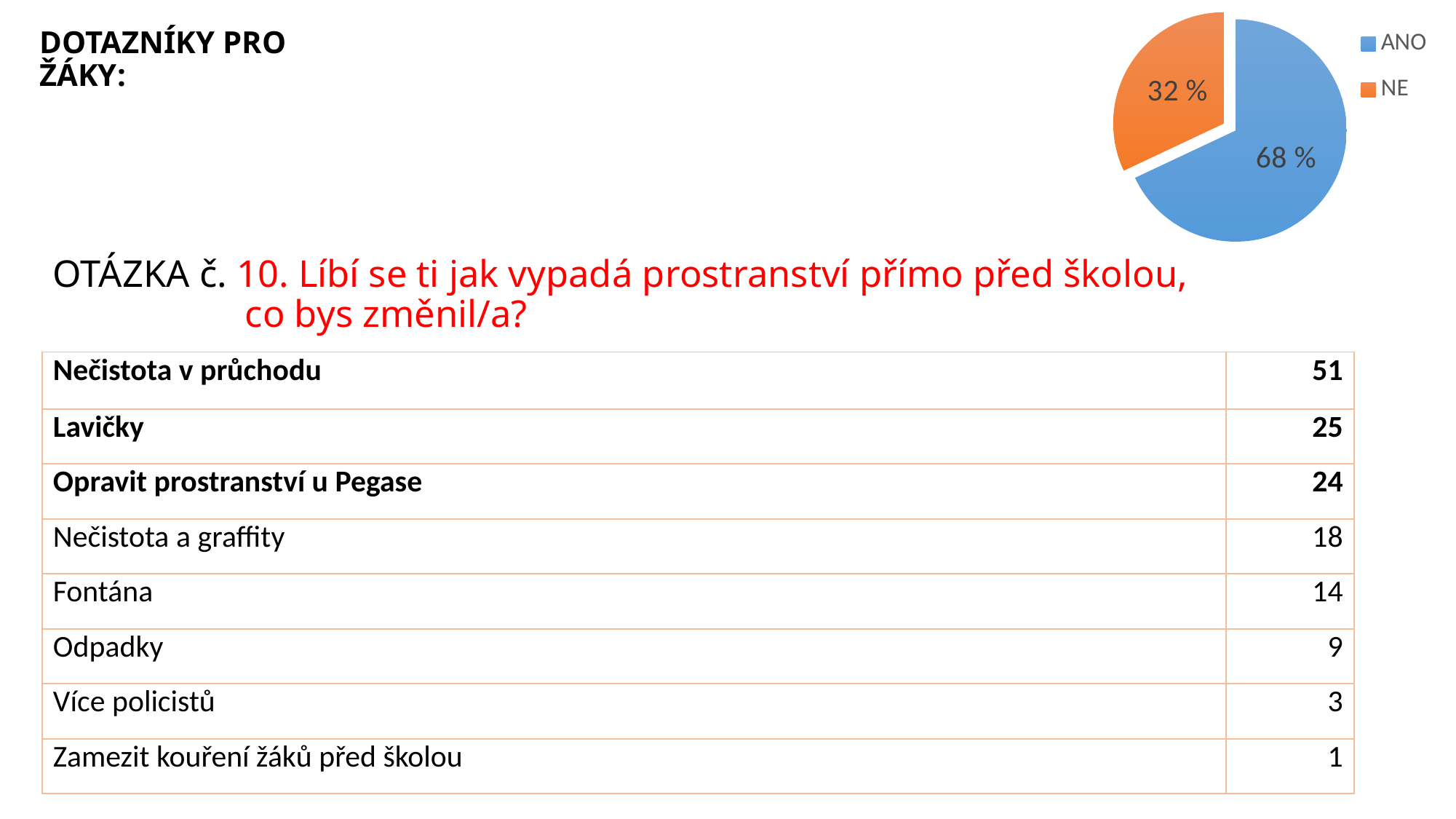
What colour is the ANO slice in the pie chart? blue In the pie chart, which is larger, ANO or NE? ANO What share of the pie chart is labelled NE? 32 % Which slice of the pie chart is the smallest? NE How many entries does the pie chart legend list? 2 What is the difference in percentage points between the ANO and NE slices of the pie chart? 36 What colour is the NE slice in the pie chart? orange What kind of chart is shown in the top right of the slide? pie chart Which slice of the pie chart is the largest? ANO How many slices does the pie chart have? 2 What share of the pie chart is labelled ANO? 68 %